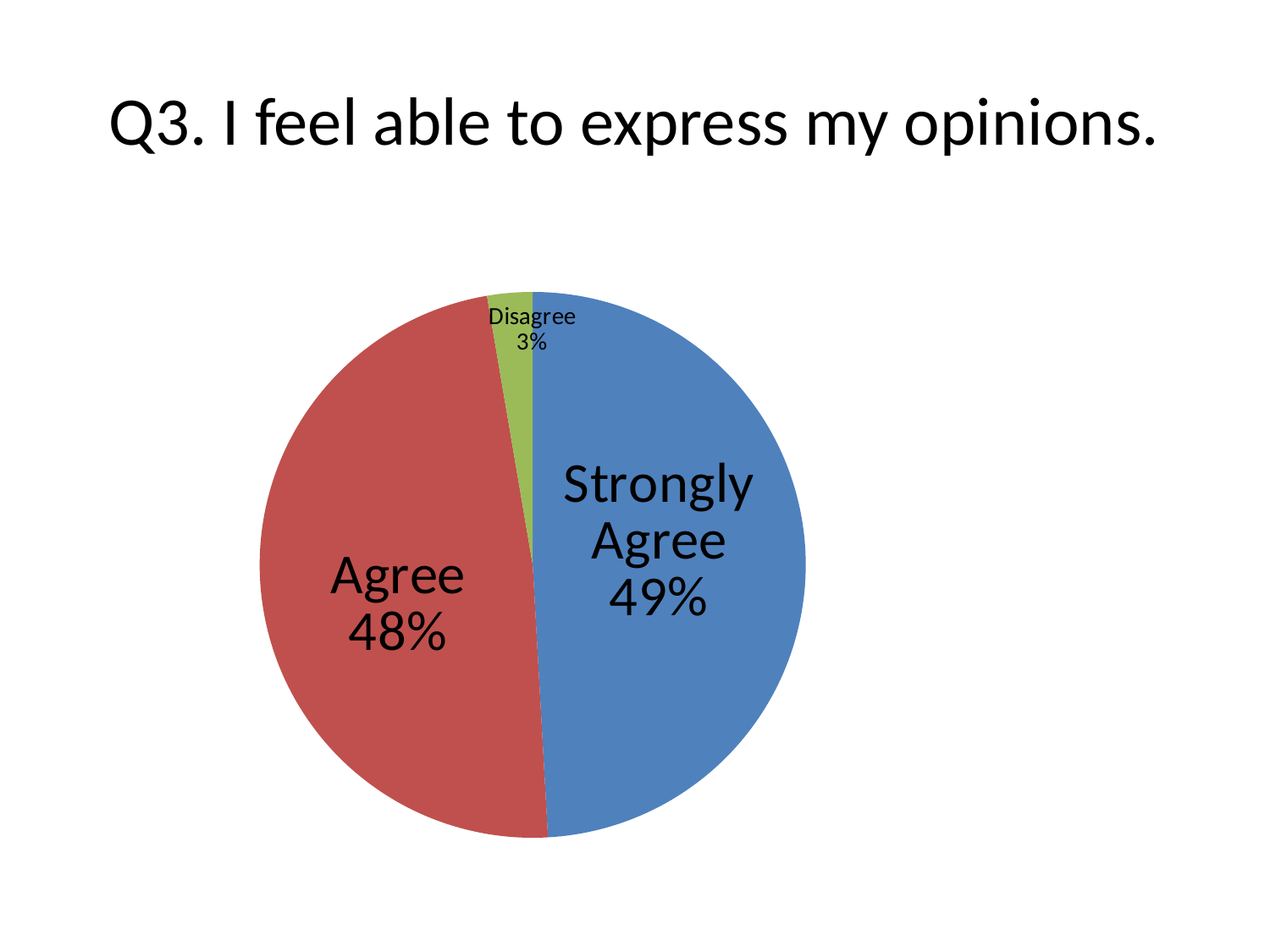
Which is larger, the Agree slice or the Disagree slice? Agree What kind of chart is shown on the slide? pie chart What percentage of respondents chose Strongly Agree? 49% What colour is the Disagree slice? green Which response has the smallest share of the pie? Disagree What is the title of the slide? Q3. I feel able to express my opinions. What percentage of respondents chose Agree? 48% What is the difference in percentage points between Strongly Agree and Disagree? 46 How many slices does the pie chart have? 3 What is the difference in percentage points between Agree and Disagree? 45 What is the combined share of Strongly Agree and Agree? 97% What percentage of respondents chose Disagree? 3%